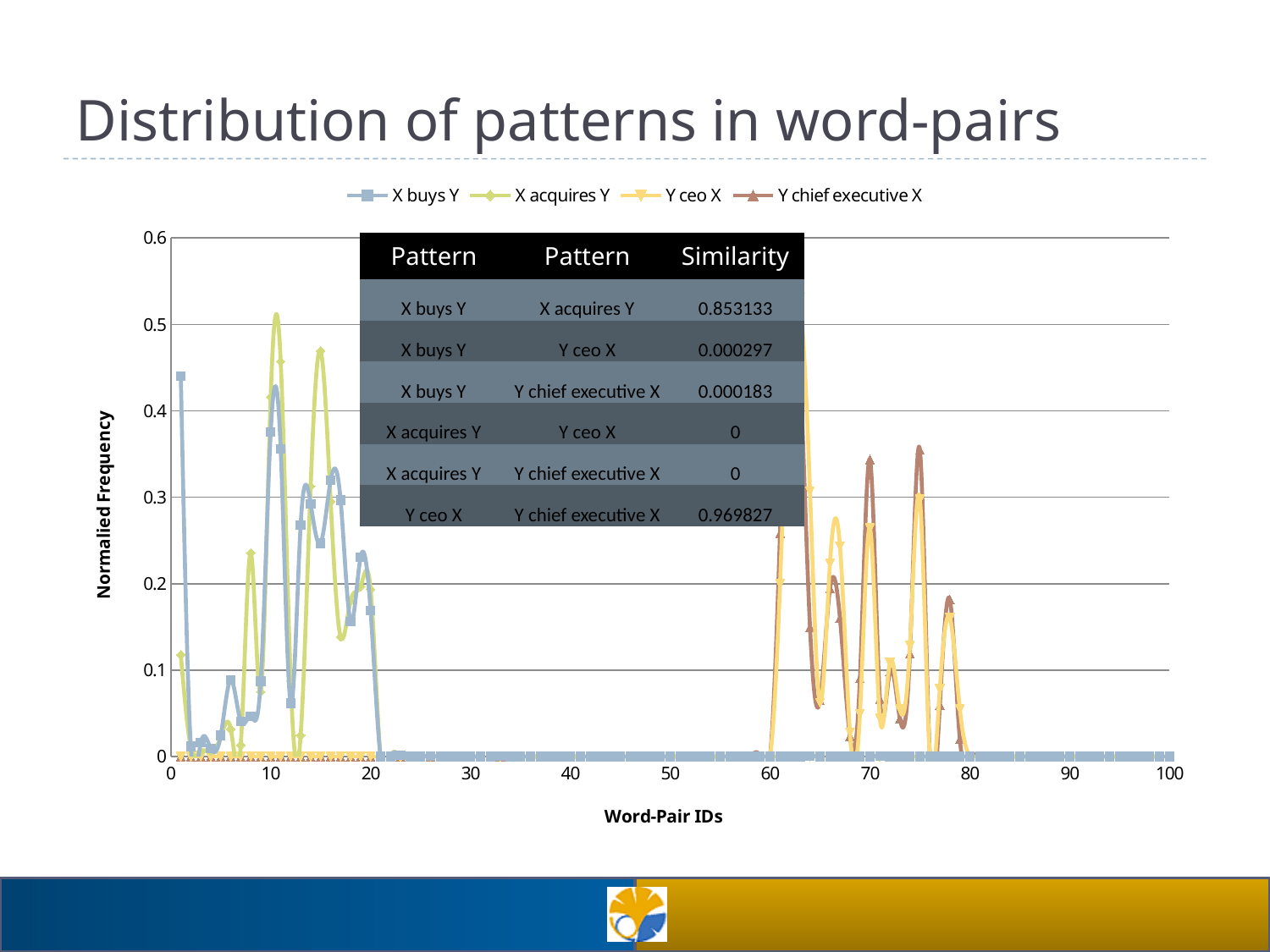
Is the value for Y ceo X at word-pair ID 78 greater or less than 0.2? less What is the title of the y axis? Normalied Frequency Is the value for X buys Y at word-pair ID 5 greater or less than 0.1? less What kind of chart is shown on the slide? line chart Is the value for X buys Y at word-pair ID 50 greater or less than 0.1? less How many series does the legend list? 4 At word-pair ID 10, which series has the larger value, X buys Y or Y ceo X? X buys Y At word-pair ID 70, which series has the larger value, Y chief executive X or X acquires Y? Y chief executive X What is the title of the x axis? Word-Pair IDs